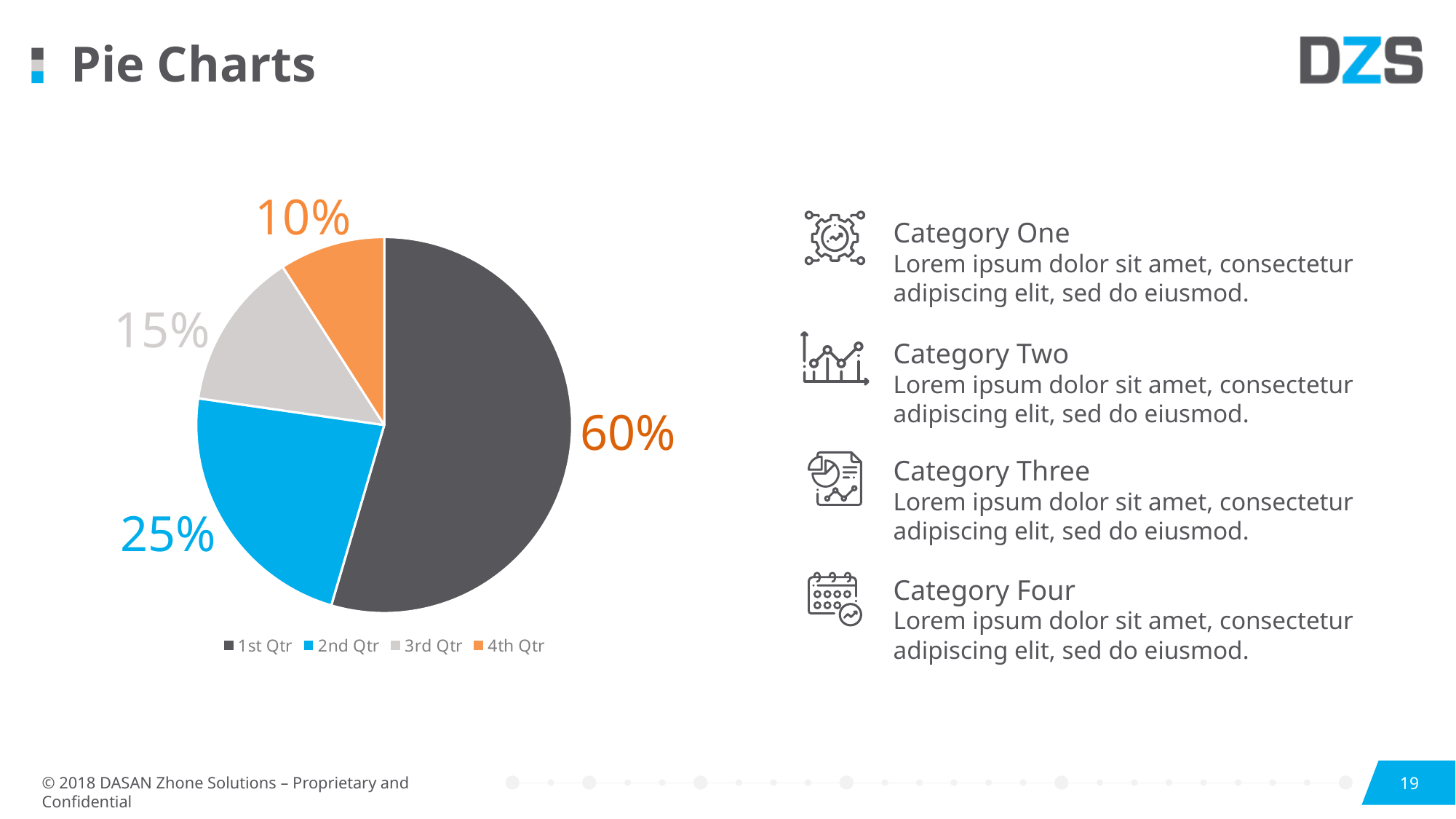
What is the value for 3rd Qtr? 15% What is the value for 4th Qtr? 10% Which quarter has the largest slice? 1st Qtr What is the difference between the 1st Qtr and 2nd Qtr values? 35% Which quarter has the smallest slice? 4th Qtr Which is larger, the 3rd Qtr slice or the 4th Qtr slice? 3rd Qtr How many slices does the pie chart have? 4 What is the value for 1st Qtr? 60% What colour is the 2nd Qtr slice? blue How many entries does the legend list? 4 What is the value for 2nd Qtr? 25% What kind of chart is shown on the slide? pie chart